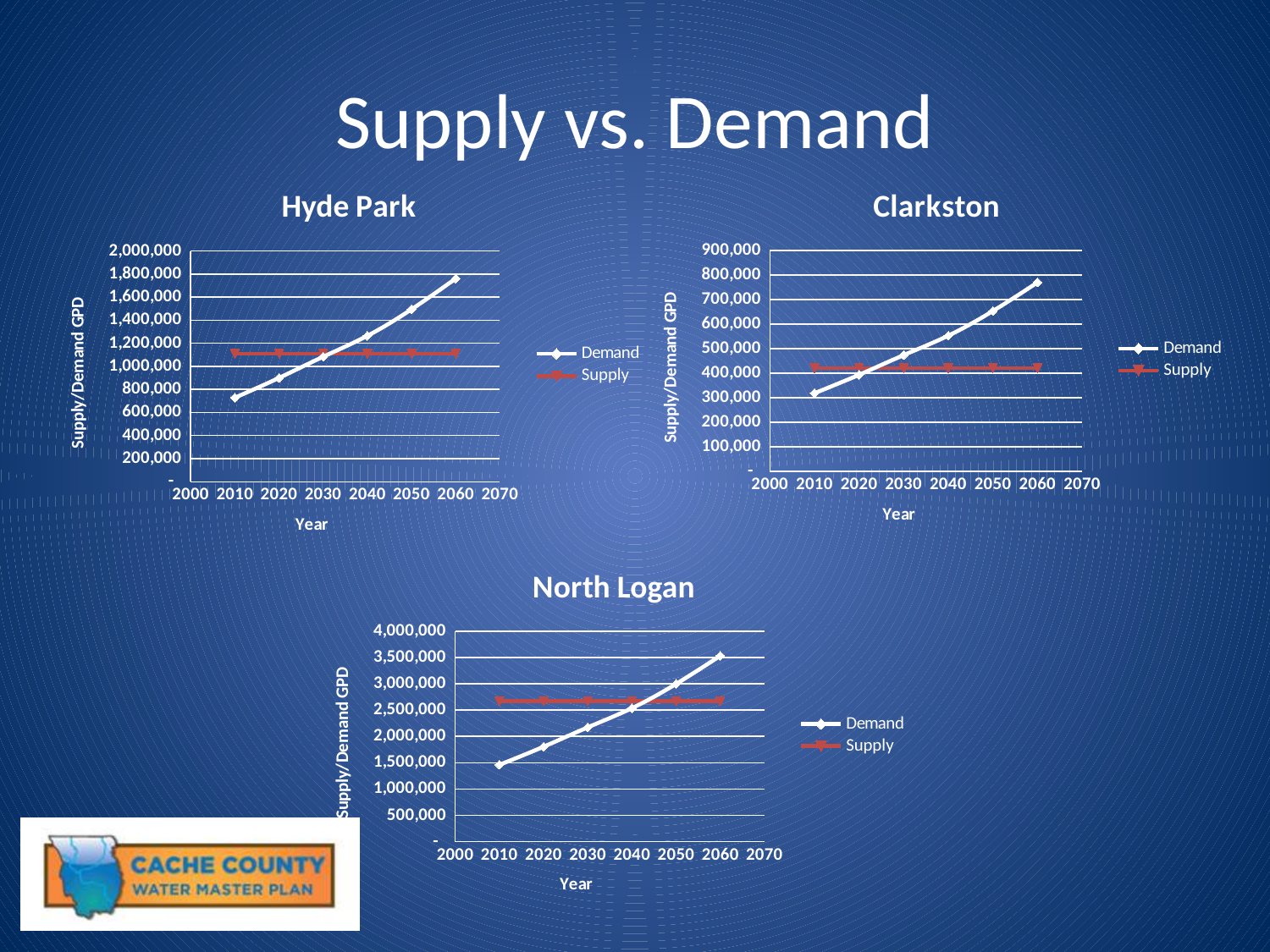
In the Hyde Park chart, does the Demand series rise or fall from 2010 to 2060? rise In the Clarkston chart, how many data points does the Demand series have? 6 In the Clarkston chart, which is larger in 2010, Demand or Supply? Supply In the Hyde Park chart, is the Demand value for 2060 greater or less than 1,600,000? greater What is the x-axis title of the North Logan chart? Year In the North Logan chart, is the Supply value greater or less than 2,500,000? greater In the North Logan chart, is the Demand value for 2060 greater or less than 3,000,000? greater How many series does the legend of the Clarkston chart list? 2 What kind of chart is the Hyde Park chart? line chart In the Hyde Park chart, which is larger in 2060, Demand or Supply? Demand